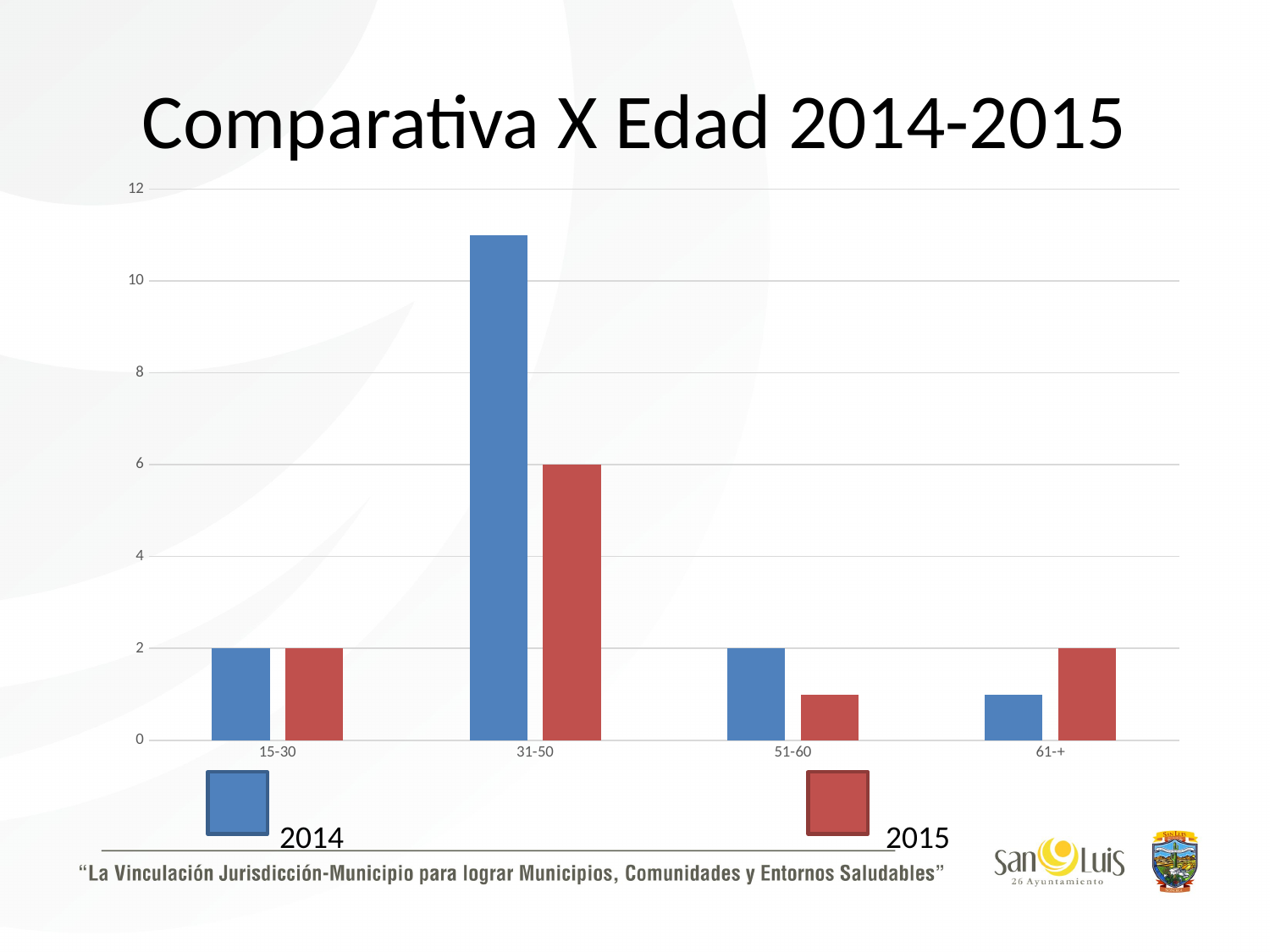
How many series does the legend list? 2 Which colour represents the 2015 series? red How many age categories are shown on the x axis? 4 Is the value for 2015 in the 51-60 age group greater or less than 2? less Which age group has the highest value for 2014? 31-50 In the 31-50 age group, which year has the larger value, 2014 or 2015? 2014 What is the value for 2014 in the 15-30 age group? 2 What type of chart is shown on the slide? bar chart What is the value for 2014 in the 51-60 age group? 2 Is the value for 2014 in the 31-50 age group greater or less than 10? greater What is the value for 2015 in the 31-50 age group? 6 What is the value for 2015 in the 61-+ age group? 2